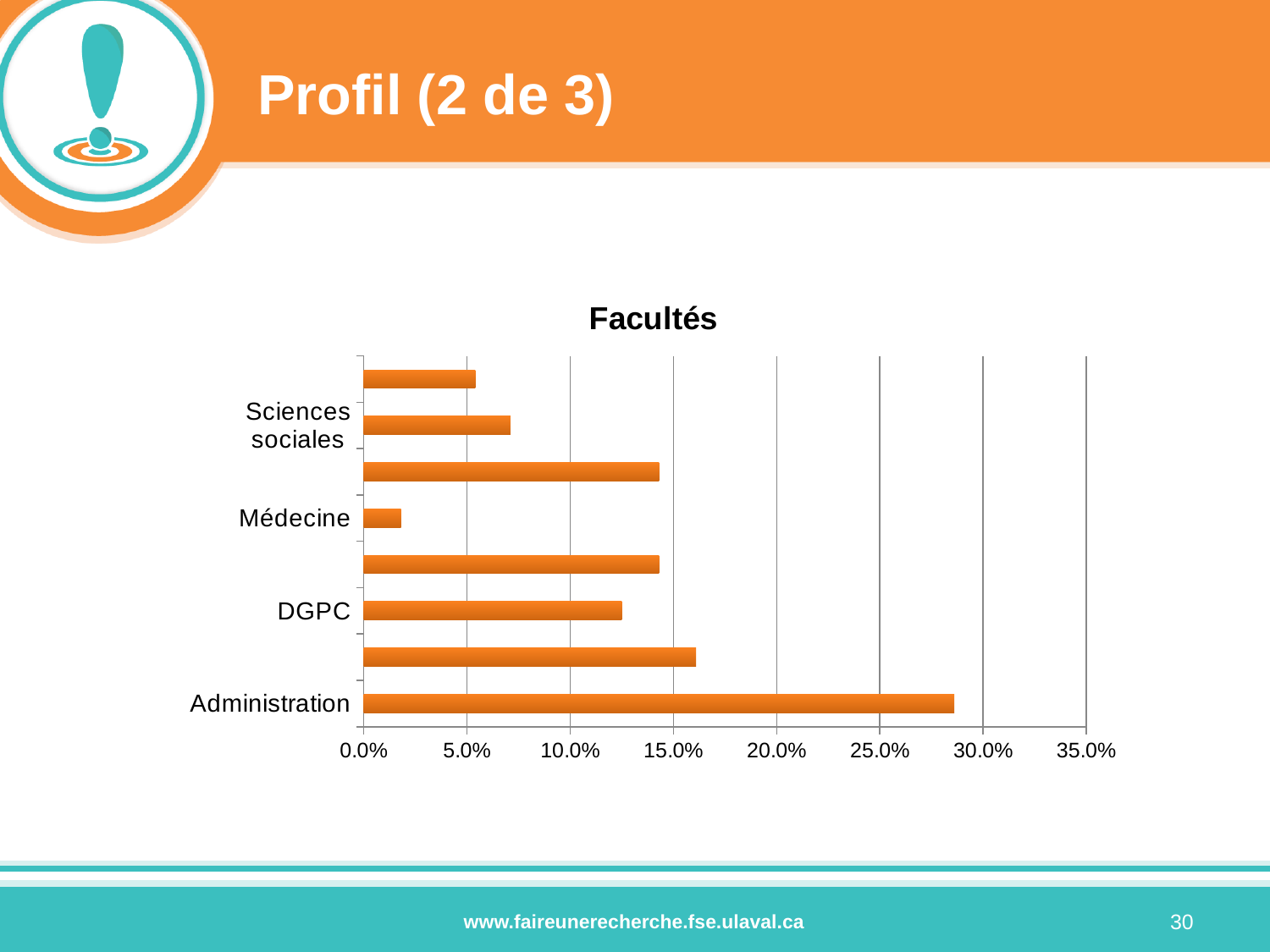
What is the highest value shown on the horizontal axis? 35.0% Is the value for Administration greater or less than 25.0%? greater What kind of chart is shown on the slide? bar chart Which labelled faculty has the lowest value? Médecine Which is larger, the value for DGPC or the value for Médecine? DGPC How many bars are plotted in the chart? 8 Which labelled faculty has the highest value? Administration Is the value for DGPC greater or less than 10.0%? greater Which is larger, the value for Administration or the value for DGPC? Administration What is the title of the chart? Facultés Is the value for Sciences sociales greater or less than 10.0%? less